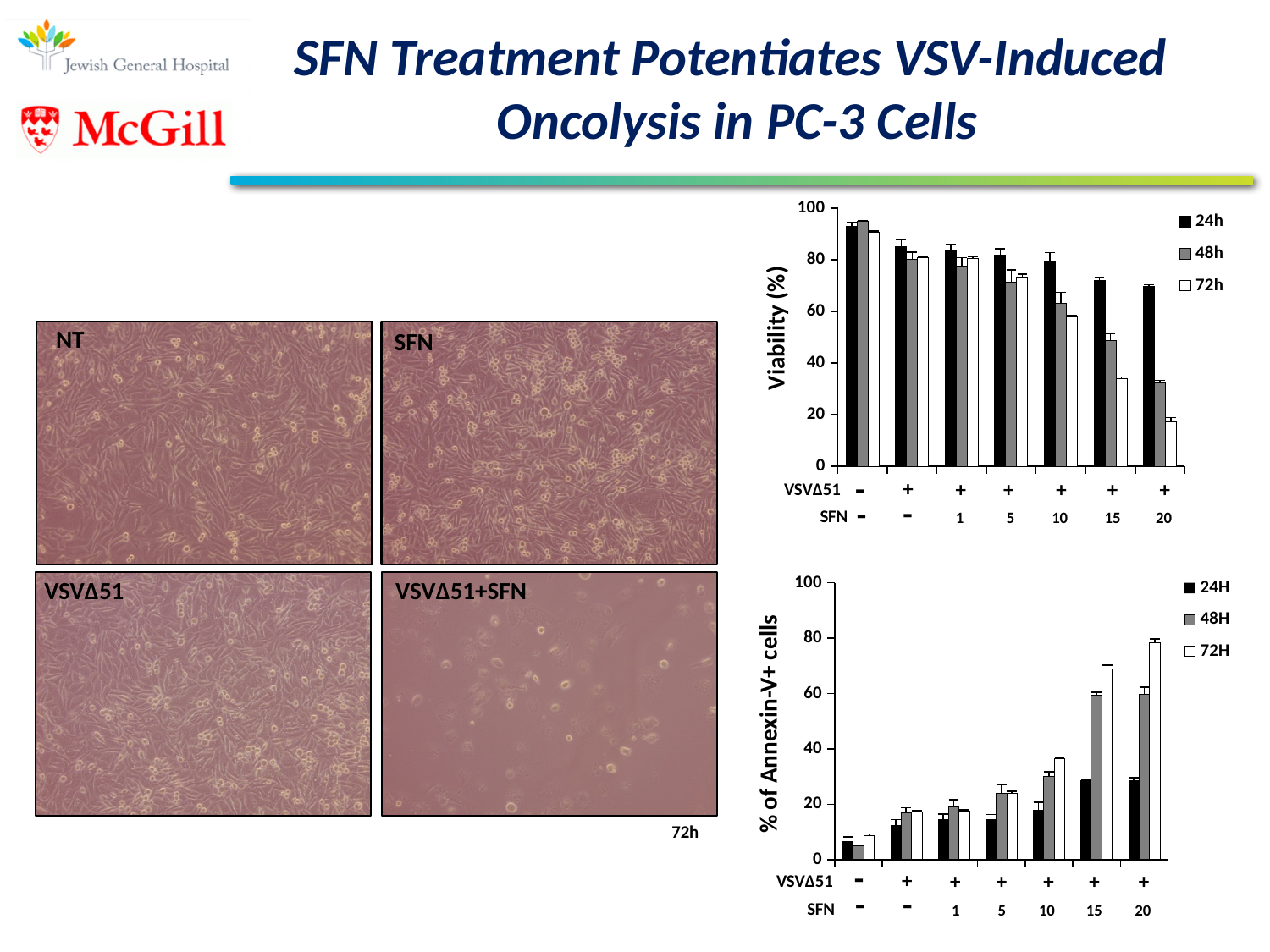
In the bottom chart (% of Annexin-V+ cells), which bar is the highest? 72H at SFN 20 How many treatment groups are plotted along the x axis of the top chart (Viability (%))? 7 In the top chart (Viability (%)), at SFN 20, which is larger: the 24h value or the 72h value? 24h What is the y-axis label of the bottom chart? % of Annexin-V+ cells In the top chart (Viability (%)), is the 72h value at SFN 20 greater or less than 40? less In the top chart (Viability (%)), is the 24h value at SFN 20 greater or less than 60? greater In the bottom chart (% of Annexin-V+ cells), is the 72H value at SFN 20 greater or less than 60? greater How many series does the legend of the bottom chart (% of Annexin-V+ cells) list? 3 What kind of chart is the top chart (Viability (%))? bar chart How many series does the legend of the top chart (Viability (%)) list? 3 In the bottom chart (% of Annexin-V+ cells), does the 72H series rise or fall as the SFN dose increases from 1 to 20? rise In the top chart (Viability (%)), does the 72h series rise or fall as the SFN dose increases from 1 to 20? fall